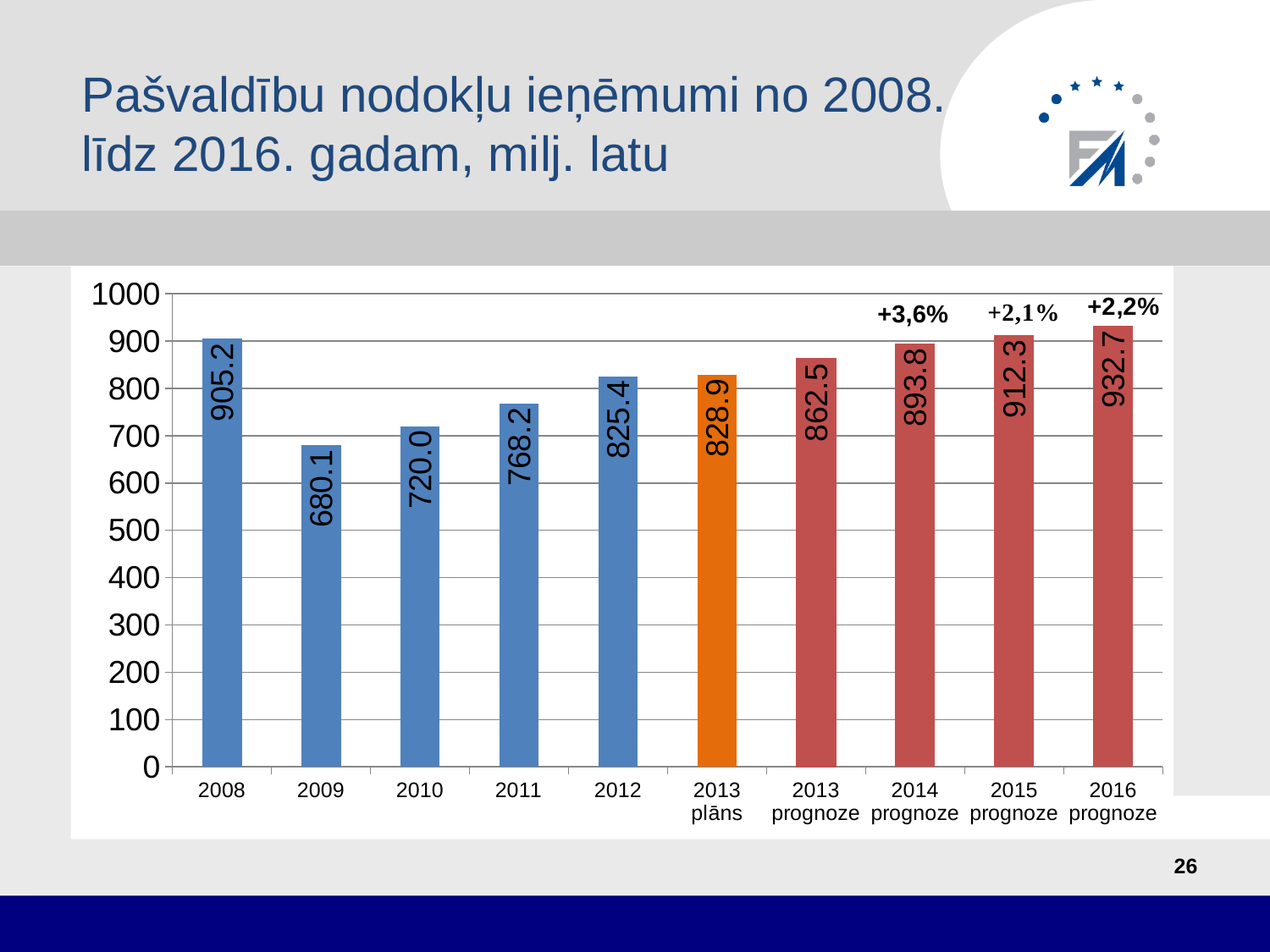
What colour is the bar for 2013 plāns? orange What percentage change is printed above the 2014 prognoze bar? +3,6% What is the difference between the values for 2008 and 2009? 225.1 Do the values rise or fall from 2009 to 2016 prognoze? rise Which category has the highest value? 2016 prognoze What kind of chart is shown on the slide? bar chart Which category has the lowest value? 2009 What is the value for 2016 prognoze? 932.7 How many bars are shown in the chart? 10 Which is larger, the value for 2013 plāns or the value for 2013 prognoze? 2013 prognoze What is the value for 2013 plāns? 828.9 What is the value for 2008? 905.2